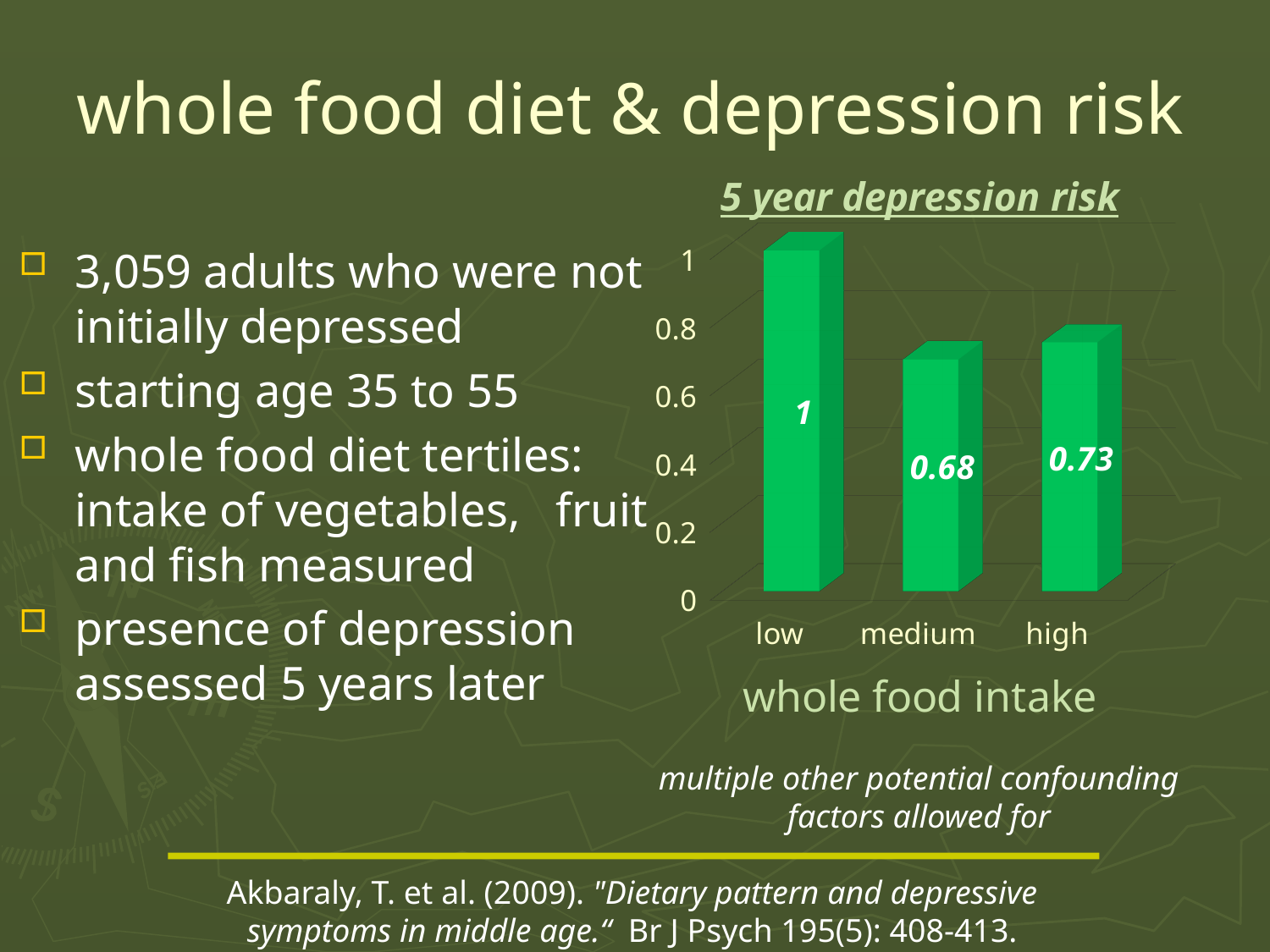
What is the difference in 5 year depression risk between the high and medium intake groups? 0.05 What is the title of the chart? 5 year depression risk What is the 5 year depression risk for the low whole food intake group? 1 What kind of chart is used to show 5 year depression risk? bar chart Which has a higher 5 year depression risk, the medium or the high intake group? high What is the difference in 5 year depression risk between the low and medium intake groups? 0.32 What is the 5 year depression risk for the high whole food intake group? 0.73 Which whole food intake group has the highest 5 year depression risk? low How many whole food intake categories are shown on the chart? 3 Is the 5 year depression risk for the medium intake group greater or less than 0.8? less Which whole food intake group has the lowest 5 year depression risk? medium What is the 5 year depression risk for the medium whole food intake group? 0.68